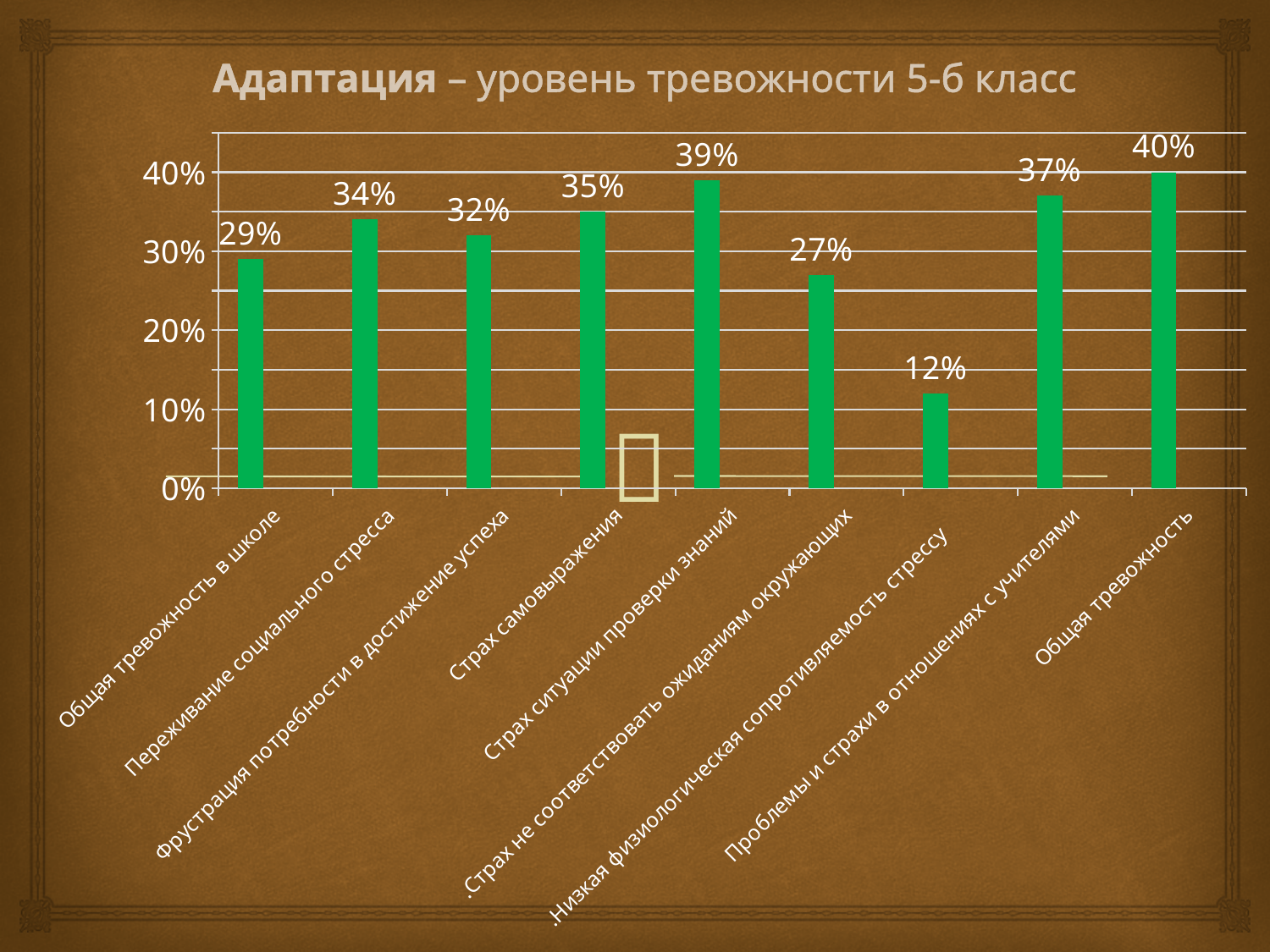
What is the value for «Общая тревожность в школе»? 29% Which is larger: «Переживание социального стресса» or «Фрустрация потребности в достижение успеха»? Переживание социального стресса What is the difference between «Страх самовыражения» and «Страх не соответствовать ожиданиям окружающих»? 8% What is the title of the chart? Адаптация – уровень тревожности 5-б класс How many categories are shown in the chart? 9 Which category has the highest value? Общая тревожность Which category has the lowest value? Низкая физиологическая сопротивляемость стрессу What is the value for «Низкая физиологическая сопротивляемость стрессу»? 12% What is the value for «Страх ситуации проверки знаний»? 39% Is the value for «Страх не соответствовать ожиданиям окружающих» greater or less than 30%? less What is the value for «Проблемы и страхи в отношениях с учителями»? 37% What kind of chart is shown on the slide? bar chart